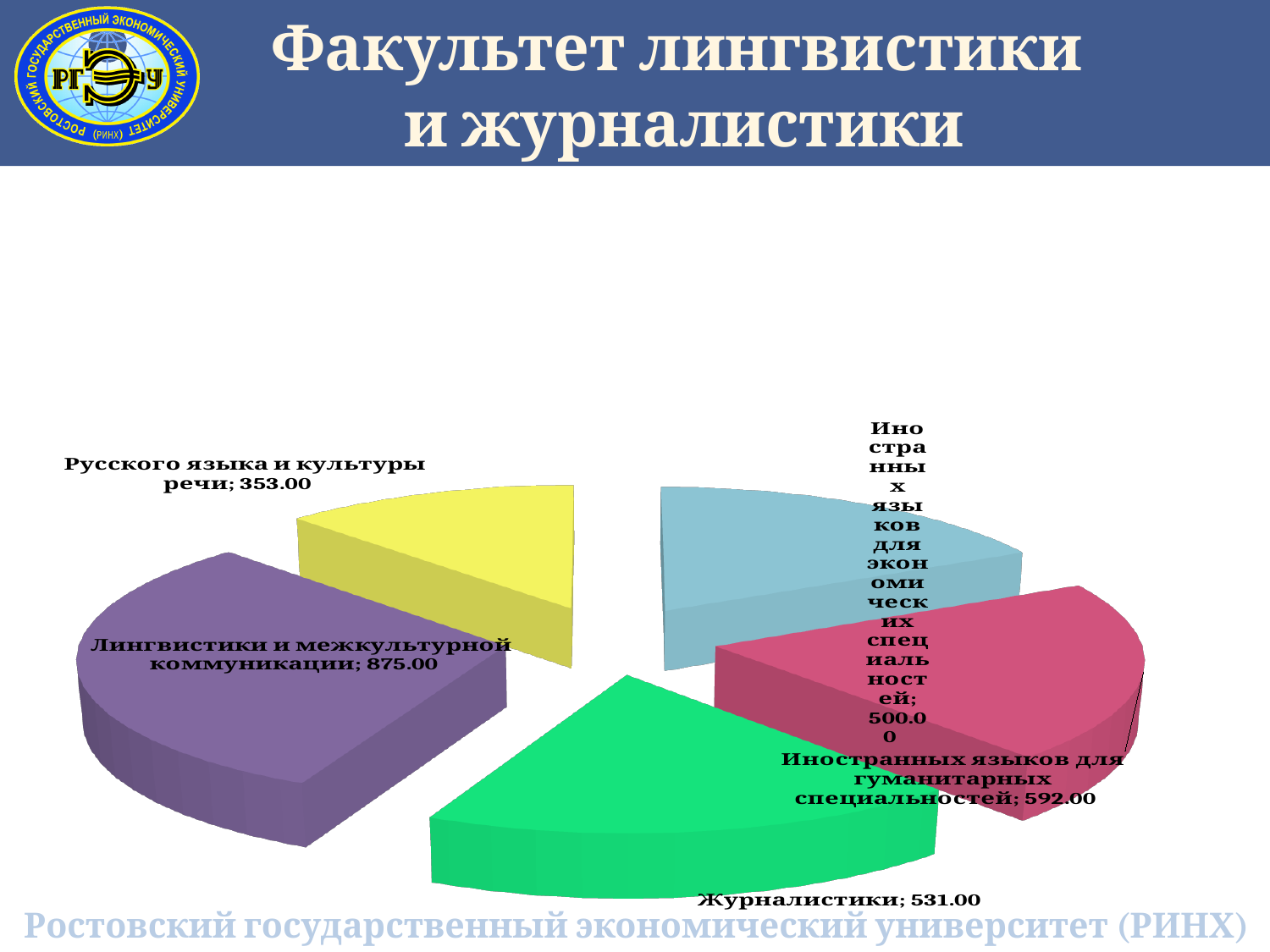
What is the difference between the values for Лингвистики и межкультурной коммуникации and Русского языка и культуры речи? 522.00 What type of chart is shown on the slide? pie chart What is the value for Иностранных языков для гуманитарных специальностей? 592.00 What colour is the slice for Журналистики? green What is the value for Русского языка и культуры речи? 353.00 What is the total of all the slices in the pie chart? 2851.00 Which is larger: Иностранных языков для гуманитарных специальностей or Иностранных языков для экономических специальностей? Иностранных языков для гуманитарных специальностей Which category has the smallest value? Русского языка и культуры речи What is the value for Лингвистики и межкультурной коммуникации? 875.00 What is the value for Журналистики? 531.00 Which category has the largest value? Лингвистики и межкультурной коммуникации How many slices does the pie chart have? 5